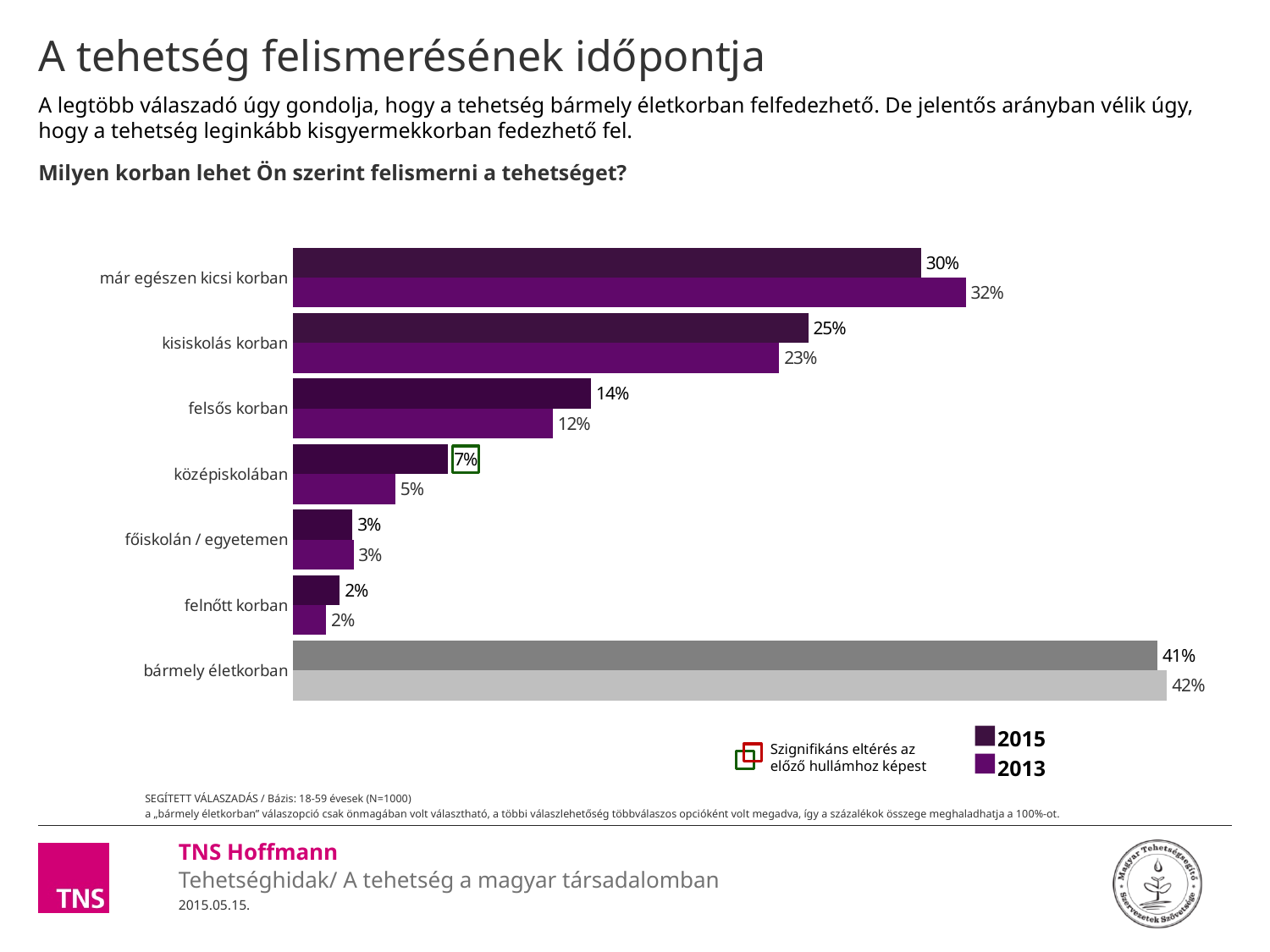
How many series does the legend list? 2 How many categories are shown on the chart? 7 What is the 2015 value for "már egészen kicsi korban"? 30% What is the difference between the 2013 and 2015 values for "már egészen kicsi korban"? 2% What kind of chart is shown on the slide? bar chart What is the 2013 value for "kisiskolás korban"? 23% What is the 2013 value for "bármely életkorban"? 42% What is the 2015 value for "középiskolában"? 7% Which is larger for "felsős korban": the 2015 value or the 2013 value? 2015 Which category has the lowest 2013 value? felnőtt korban Which category has the highest 2015 value? bármely életkorban Which years are listed in the chart legend? 2015 and 2013